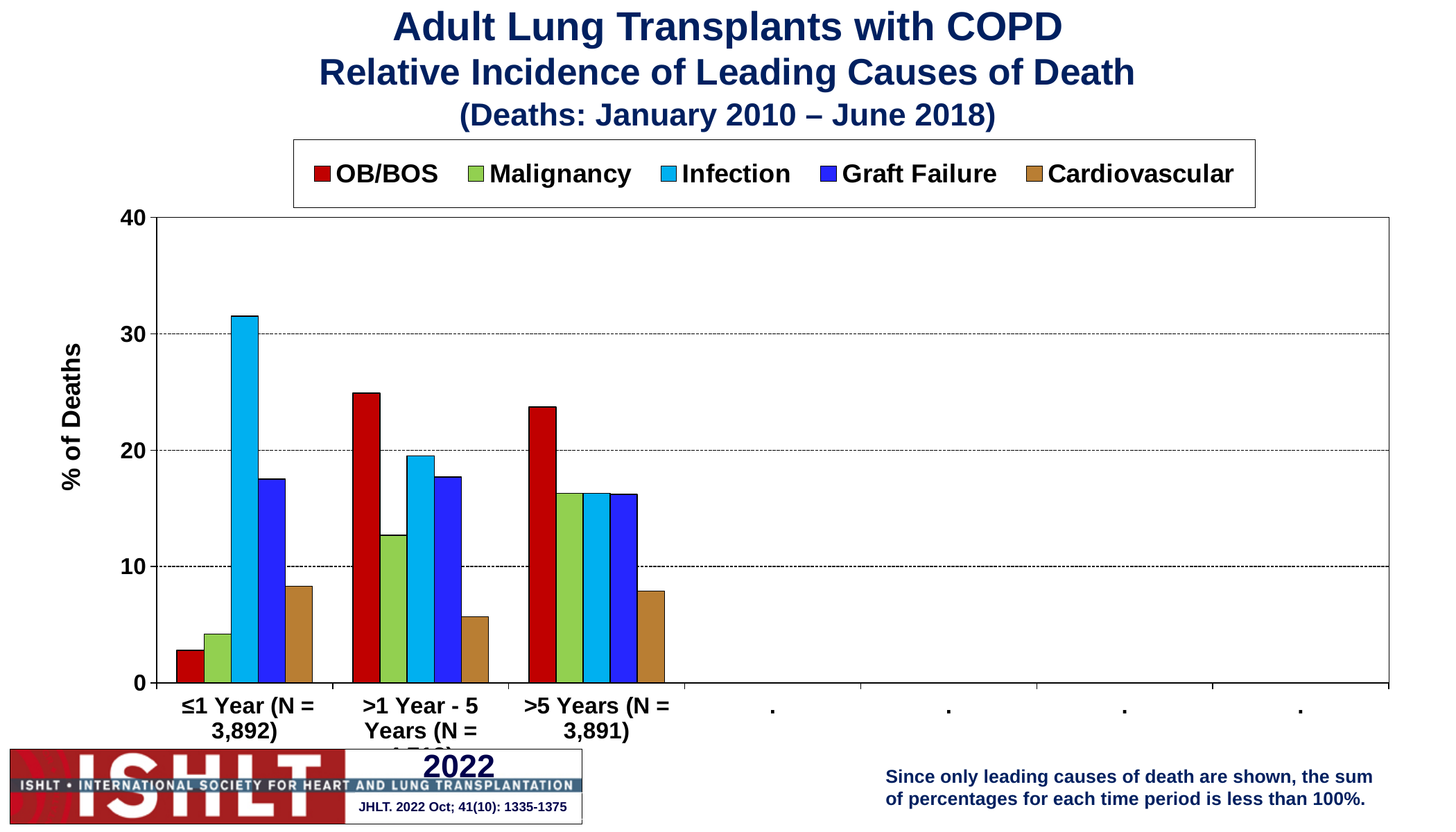
How many series does the legend list? 5 Is the value for Cardiovascular in the ≤1 Year (N = 3,892) group greater or less than 10? less In the >5 Years (N = 3,891) group, which cause of death has the lowest percentage? Cardiovascular In the ≤1 Year (N = 3,892) group, which cause of death has the highest percentage? Infection In the ≤1 Year (N = 3,892) group, which cause of death has the lowest percentage? OB/BOS Does the percentage of deaths from Infection rise or fall across the time periods from ≤1 Year to >5 Years? fall In the >1 Year - 5 Years group, which cause of death has the highest percentage? OB/BOS How many time-period groups have bars plotted on the chart? 3 In the >1 Year - 5 Years group, which cause of death has the lowest percentage? Cardiovascular What is the title of the vertical axis? % of Deaths Is the value for Infection in the ≤1 Year (N = 3,892) group greater or less than 30? greater What kind of chart is shown on the slide? bar chart